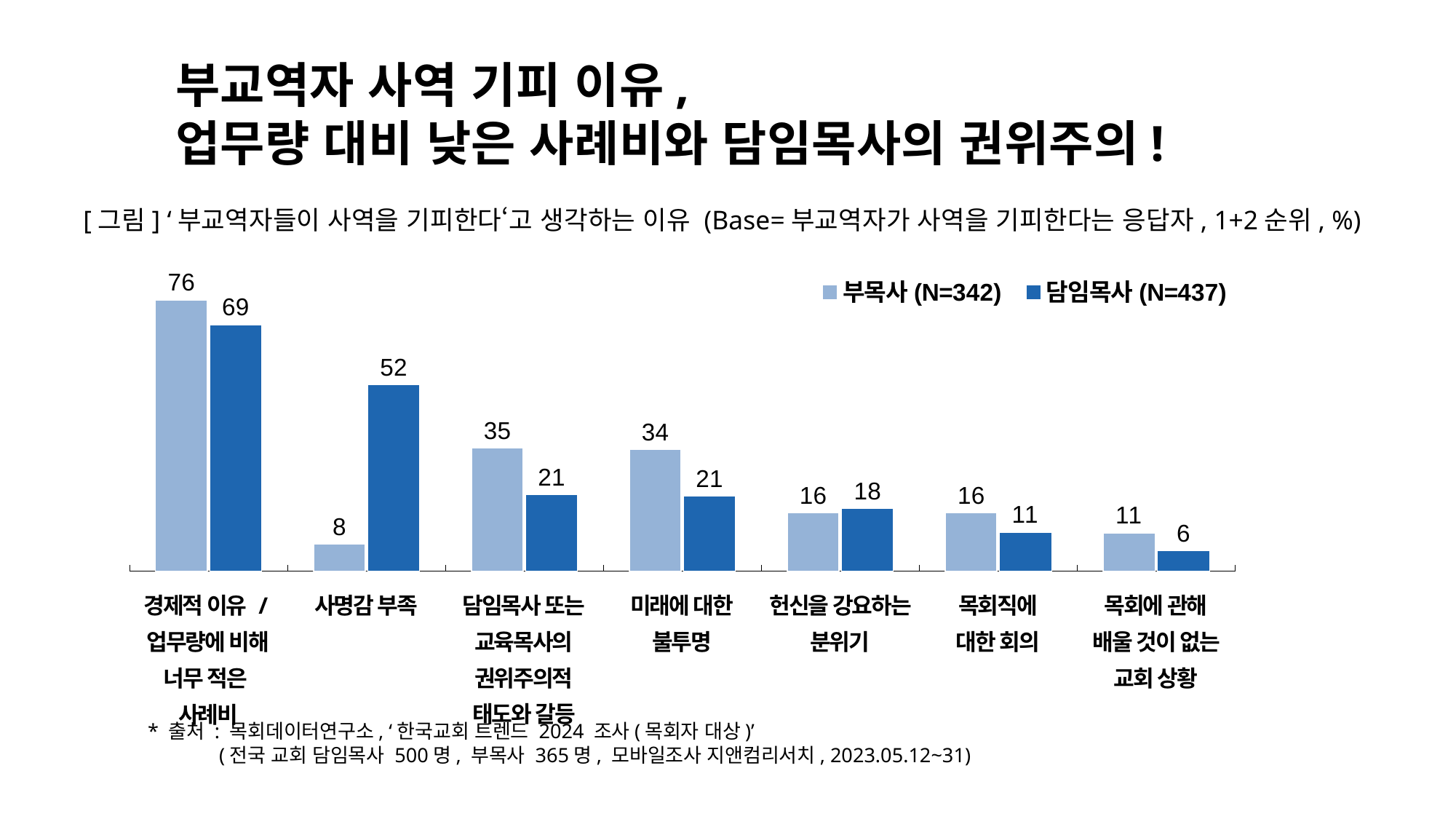
What is the difference between the 부목사 (N=342) and 담임목사 (N=437) values in the 사명감 부족 category? 44 What kind of chart is shown on the slide? Bar chart What is the value for 담임목사 (N=437) in the 사명감 부족 category? 52 Which category has the highest value for 부목사 (N=342)? 경제적 이유 / 업무량에 비해 너무 적은 사례비 What is the value for 부목사 (N=342) in the 사명감 부족 category? 8 Which category has the lowest value for 담임목사 (N=437)? 목회에 관해 배울 것이 없는 교회 상황 In the 헌신을 강요하는 분위기 category, which series has the larger value, 부목사 (N=342) or 담임목사 (N=437)? 담임목사 (N=437) How many series does the legend list? 2 What is the difference between the 부목사 (N=342) and 담임목사 (N=437) values in the 경제적 이유 / 업무량에 비해 너무 적은 사례비 category? 7 Which series is shown in the darker blue colour in the legend? 담임목사 (N=437) What is the value for 담임목사 (N=437) in the 미래에 대한 불투명 category? 21 How many categories are shown on the x axis? 7